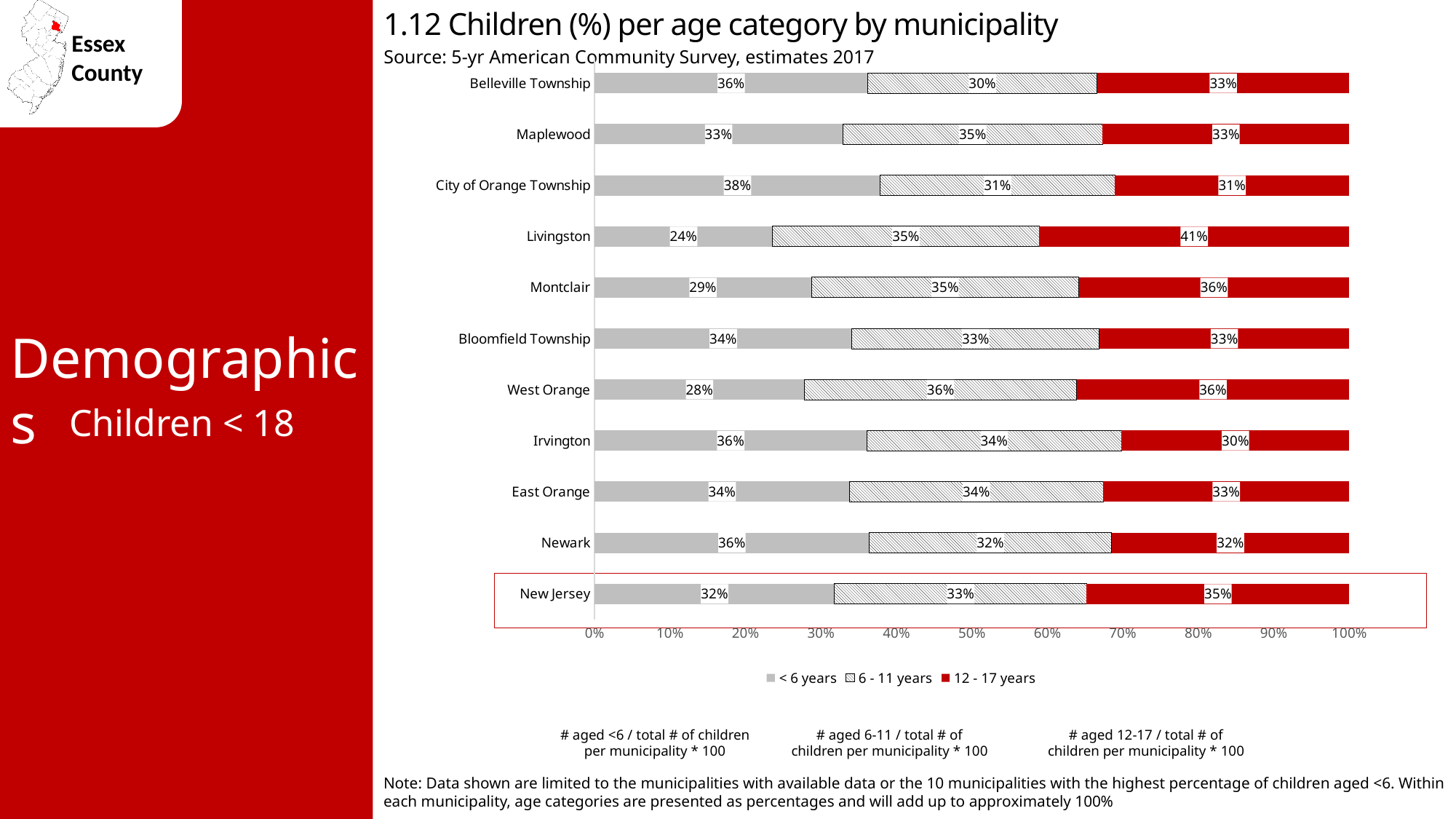
What is the value for the 6 - 11 years category in West Orange? 36% Which municipality has the highest percentage of children under 6 years? City of Orange Township How many municipalities or regions are shown on the chart? 11 What is the total of the three age categories for Livingston? 100% How many series does the legend list? 3 Which municipality has the highest percentage of children aged 12 - 17 years? Livingston What type of chart is shown on the slide? Stacked bar chart What percentage of children in Livingston are aged 12 - 17 years? 41% Which municipality has the lowest percentage of children under 6 years? Livingston What is the difference between the < 6 years percentage in Newark and in Livingston? 12% What percentage of children in City of Orange Township are under 6 years old? 38% Which is larger: the 12 - 17 years share in Montclair or in Irvington? Montclair